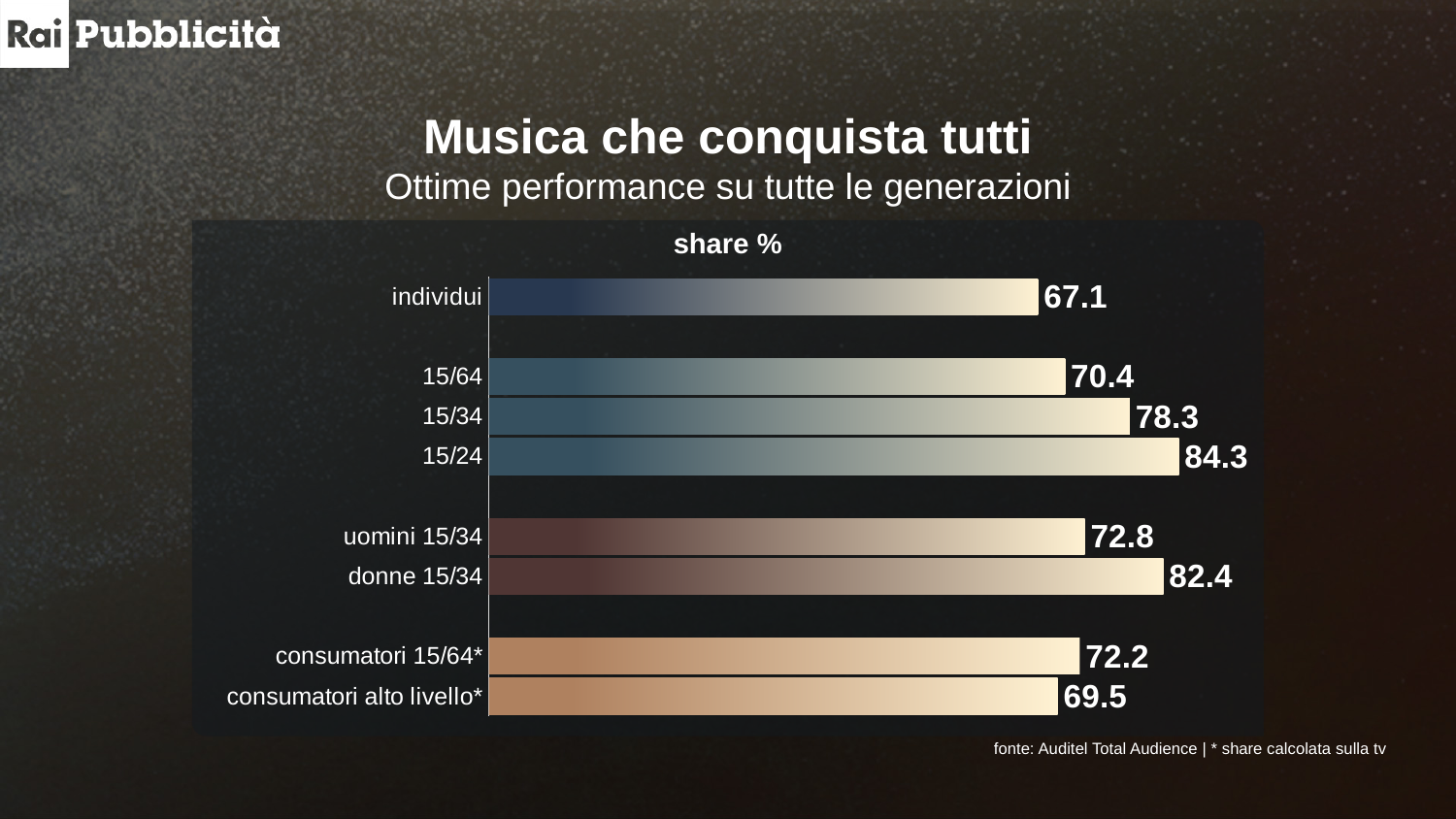
What is the share % for 15/24? 84.3 What is the difference in share % between 15/24 and 15/64? 13.9 What is the difference in share % between donne 15/34 and uomini 15/34? 9.6 What is the share % for individui? 67.1 Which has a higher share %, 15/34 or consumatori 15/64*? 15/34 What is the share % for donne 15/34? 82.4 How many categories are shown in the chart? 8 What is the share % for consumatori alto livello*? 69.5 What is the title of the chart? share % Which category has the lowest share %? individui Which category has the highest share %? 15/24 What kind of chart is shown on the slide? bar chart